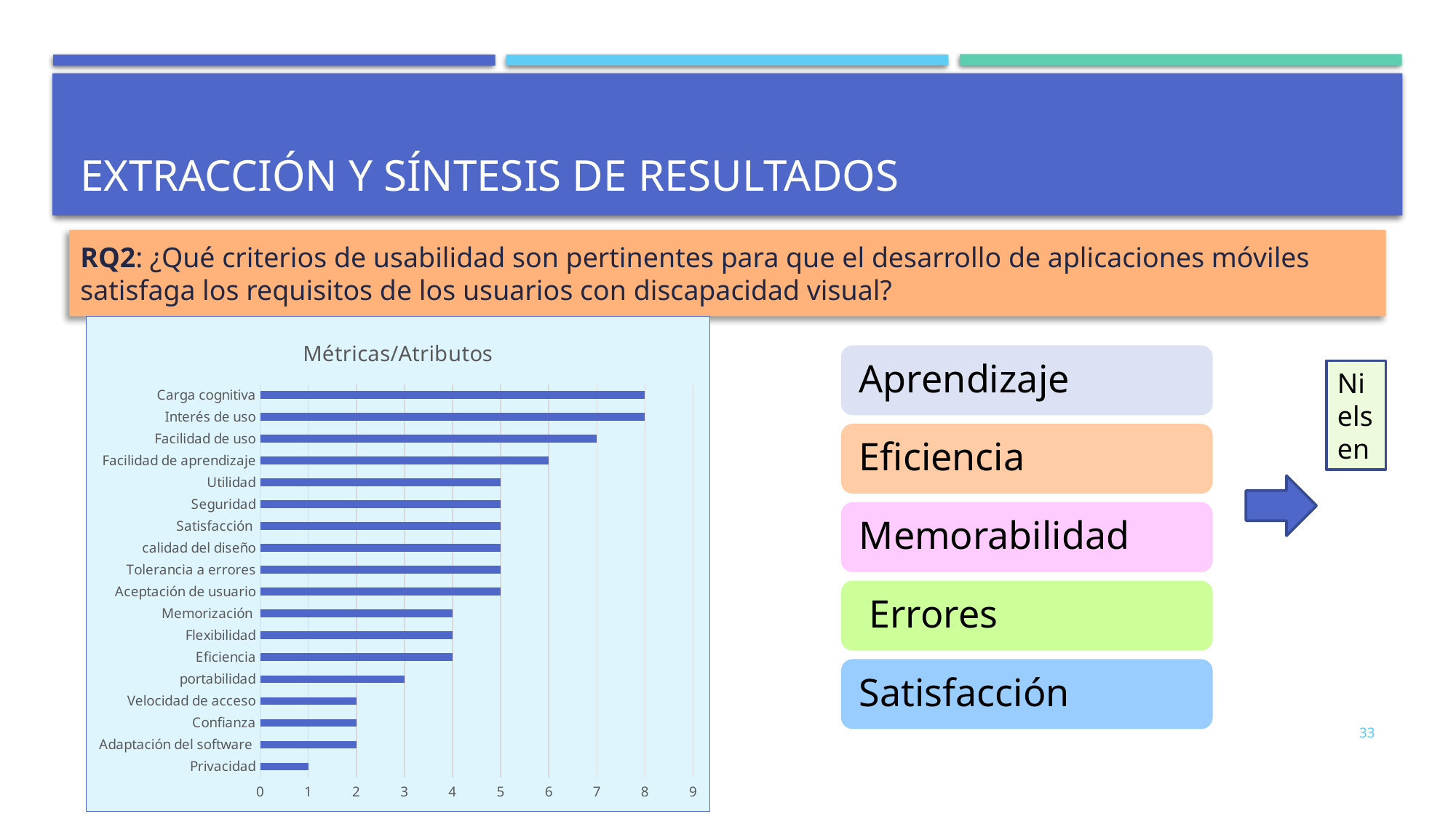
Which category has the lowest value? Privacidad How many categories are plotted in the chart? 18 What is the value for Privacidad? 1 What is the value for Facilidad de uso? 7 What is the title of the chart? Métricas/Atributos Is the value for Interés de uso greater or less than 5? greater What type of chart is shown on the slide? bar chart What is the value for portabilidad? 3 What is the value for Carga cognitiva? 8 Which is larger, the value for Facilidad de uso or the value for Memorización? Facilidad de uso What is the value for Facilidad de aprendizaje? 6 What is the difference between the values for Facilidad de uso and Privacidad? 6